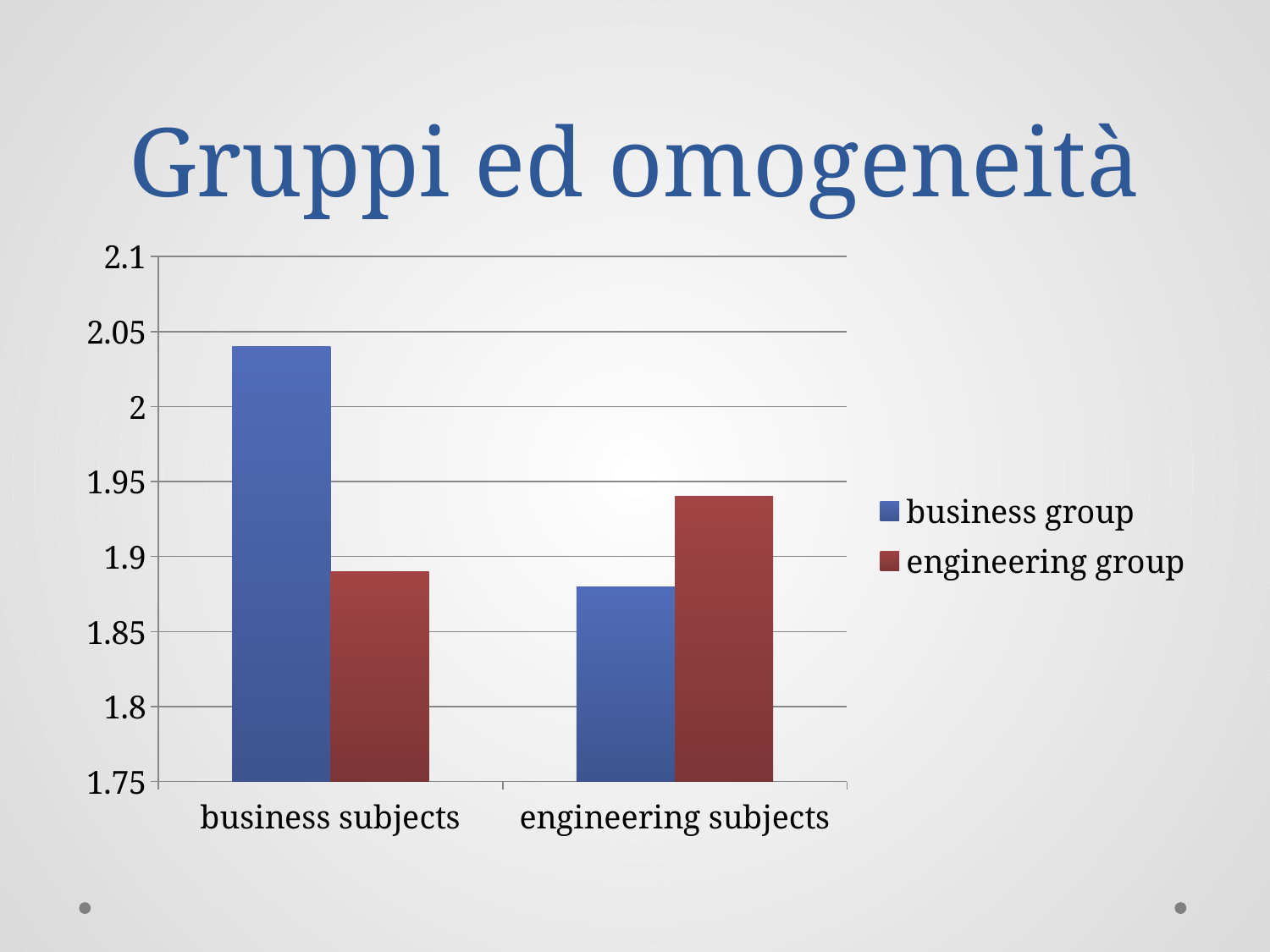
What kind of chart is shown on the slide? bar chart Is the value for the business group on engineering subjects greater or less than 1.9? less How many categories are shown on the x axis? 2 Is the value for the engineering group on business subjects greater or less than 1.9? less Is the value for the engineering group on engineering subjects greater or less than 1.9? greater How many series does the legend list? 2 Which series is shown in red? engineering group What is the title of the slide containing the chart? Gruppi ed omogeneità For business subjects, which group has the larger value? business group For engineering subjects, which group has the larger value? engineering group Which bar is the highest in the chart? business group on business subjects